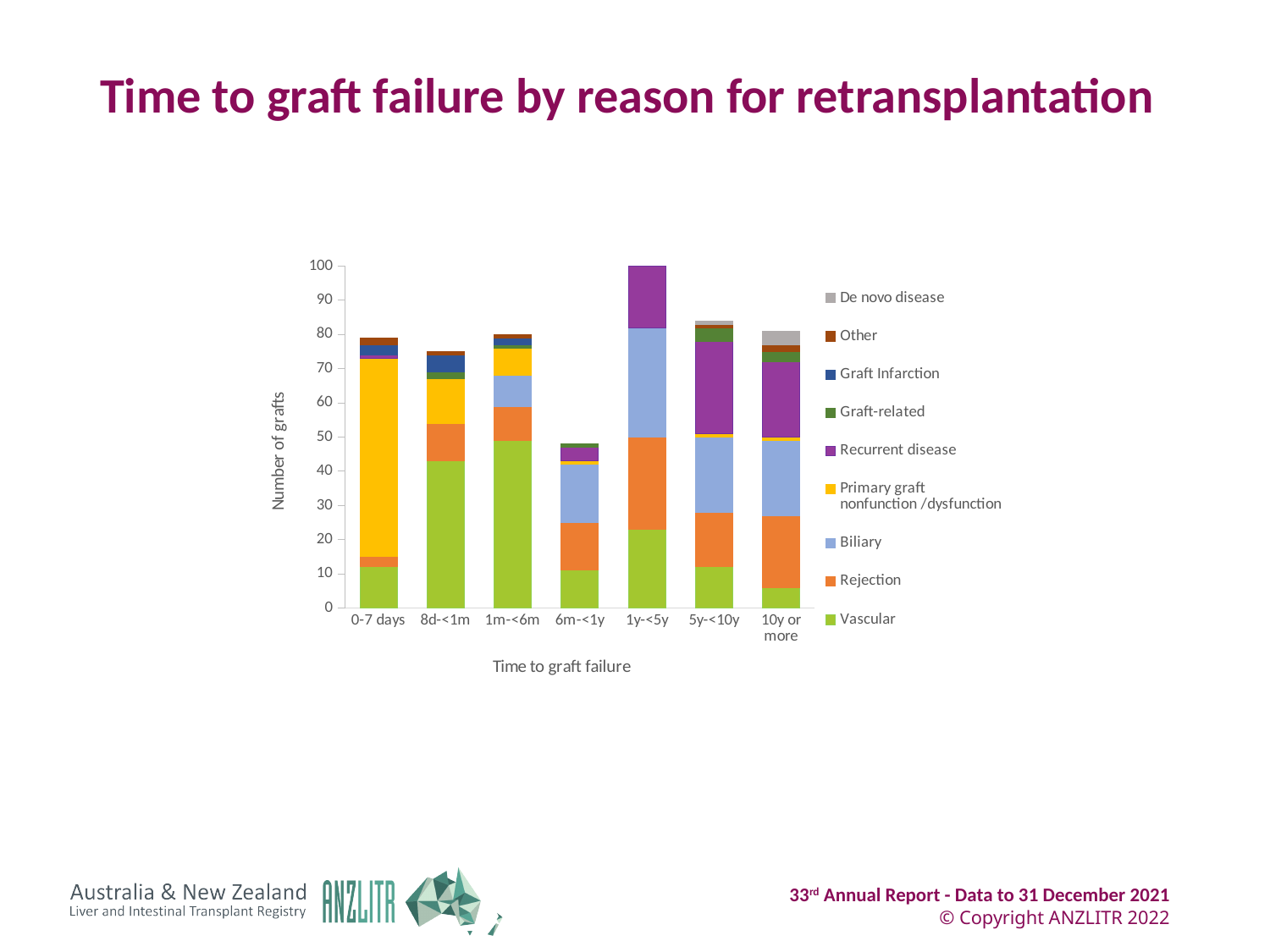
Which has a larger total number of grafts, 5y-<10y or 6m-<1y? 5y-<10y What is the title of the chart? Time to graft failure by reason for retransplantation How many time-to-graft-failure categories are shown on the x axis? 7 What kind of chart is shown on the slide? Stacked bar chart Which time-to-graft-failure category has the largest Primary graft nonfunction/dysfunction segment? 0-7 days How many series does the legend list? 9 Is the total number of grafts for 0-7 days greater or less than 70? greater Is the total number of grafts for 1y-<5y greater or less than 90? greater Is the total number of grafts for 6m-<1y greater or less than 50? less Which time-to-graft-failure category has the lowest total number of grafts? 6m-<1y Which time-to-graft-failure category has the highest total number of grafts? 1y-<5y What is the label of the y axis? Number of grafts